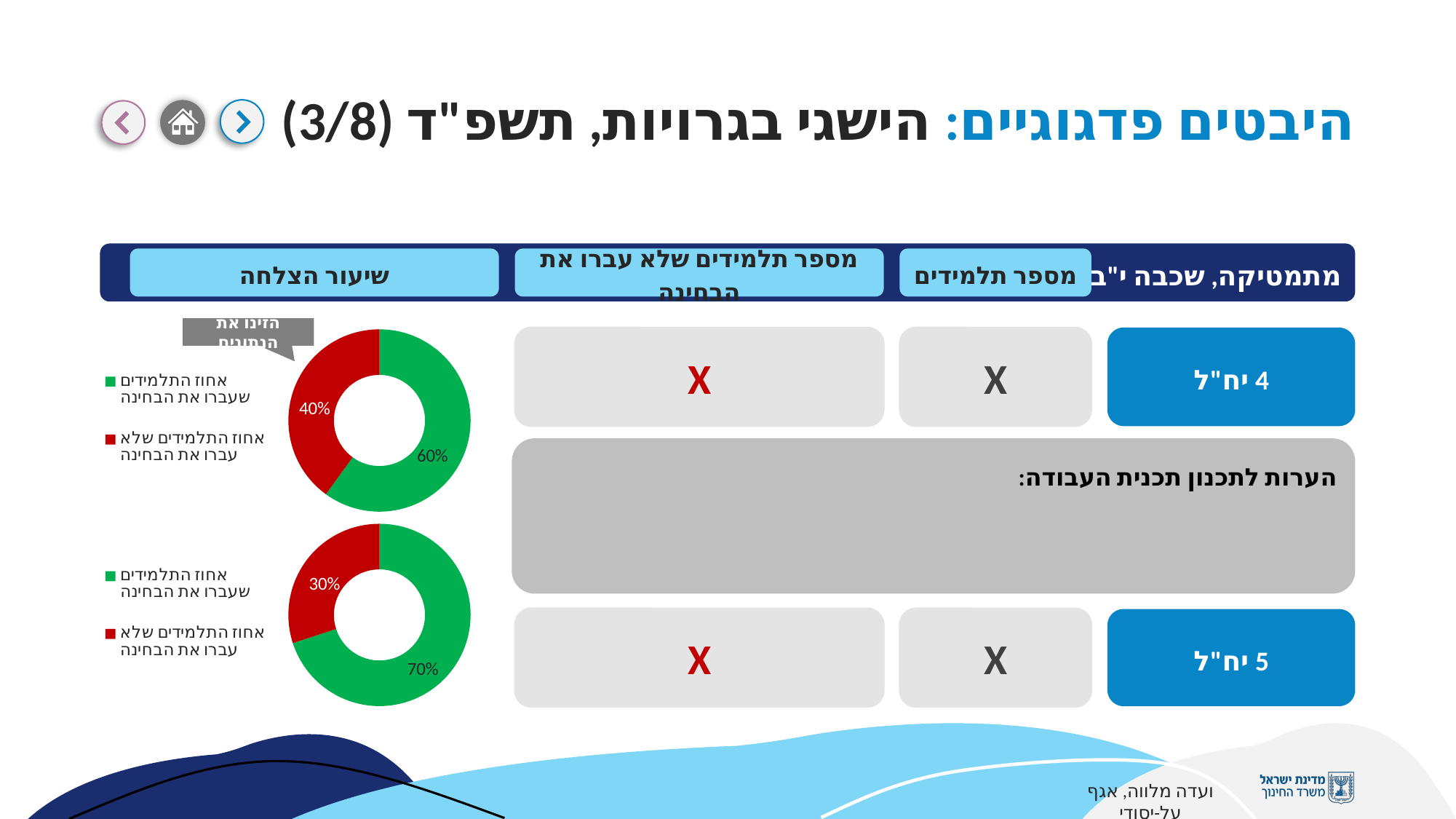
In the bottom donut chart (the 5 יח"ל row), what percentage of students passed the exam (green slice)? 70% In the top donut chart (the 4 יח"ל row), what percentage of students passed the exam (green slice)? 60% In the top donut chart (the 4 יח"ל row), what percentage of students did not pass the exam (red slice)? 40% In the bottom donut chart, which slice is the smallest? אחוז התלמידים שלא עברו את הבחינה (30%) In the top donut chart, what is the difference between the passed and not-passed percentages? 20% In the top donut chart, which slice is larger: students who passed or students who did not pass? Students who passed How many entries does the legend of the top donut chart list? 2 In the bottom donut chart, what is the difference between the passed and not-passed percentages? 40% In the bottom donut chart (the 5 יח"ל row), what percentage of students did not pass the exam (red slice)? 30% How many slices does each donut chart on the slide have? 2 In the donut charts, which colour represents students who did not pass the exam? Red What type of chart is used in the 'שיעור הצלחה' column? Donut (pie) chart